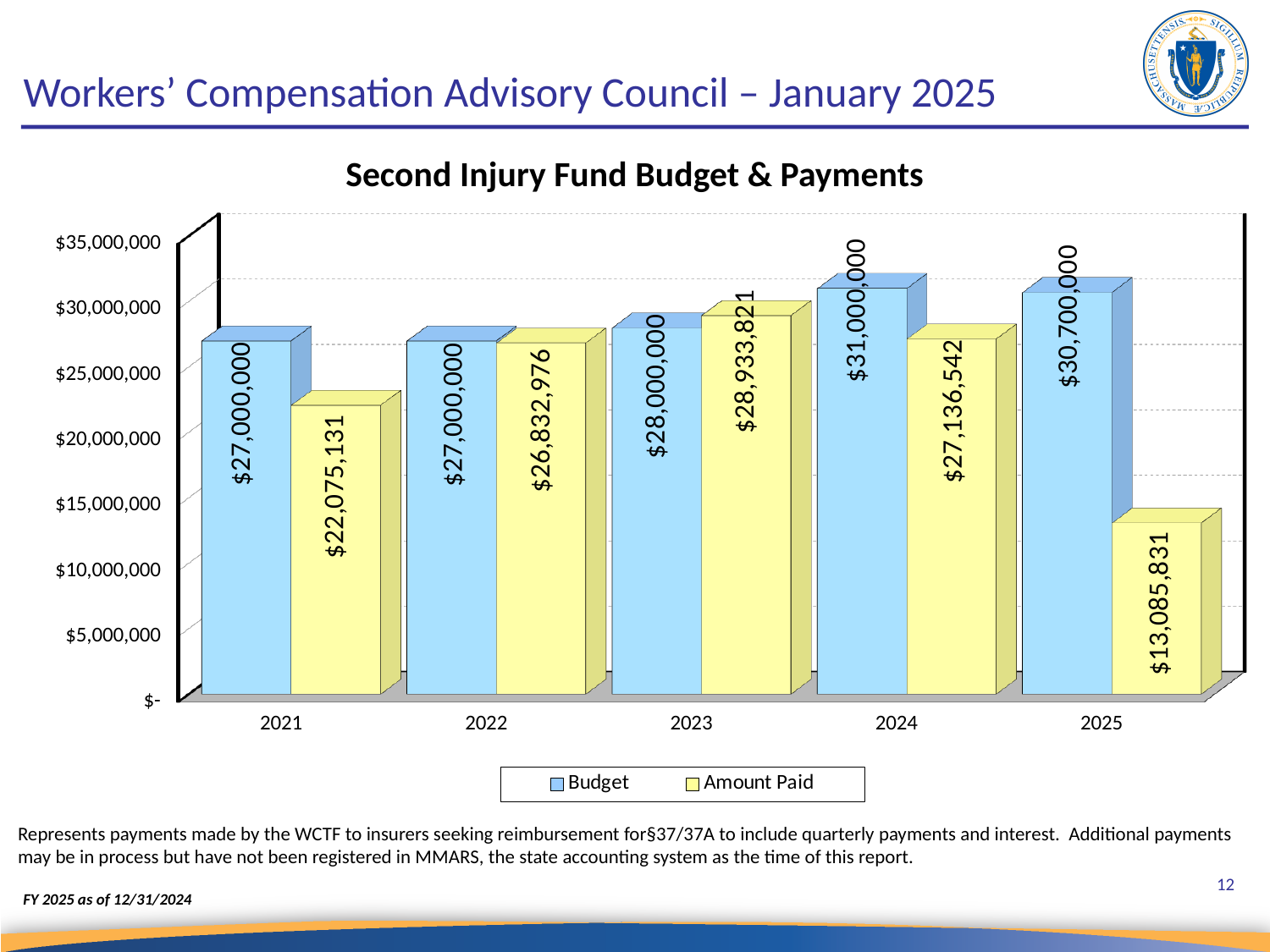
What is the Amount Paid for 2022? $26,832,976 What kind of chart is shown on the slide? Bar chart How many series does the legend list? 2 What is the Budget value for 2024? $31,000,000 Which is larger in 2024, the Budget or the Amount Paid? Budget By how much does the Amount Paid exceed the Budget in 2023? $933,821 Which year has the highest Amount Paid? 2023 Which year has the highest Budget? 2024 How many years are shown on the x axis? 5 What is the difference between the Budget and the Amount Paid in 2021? $4,924,869 What is the Amount Paid for 2025? $13,085,831 Which year has the lowest Amount Paid? 2025